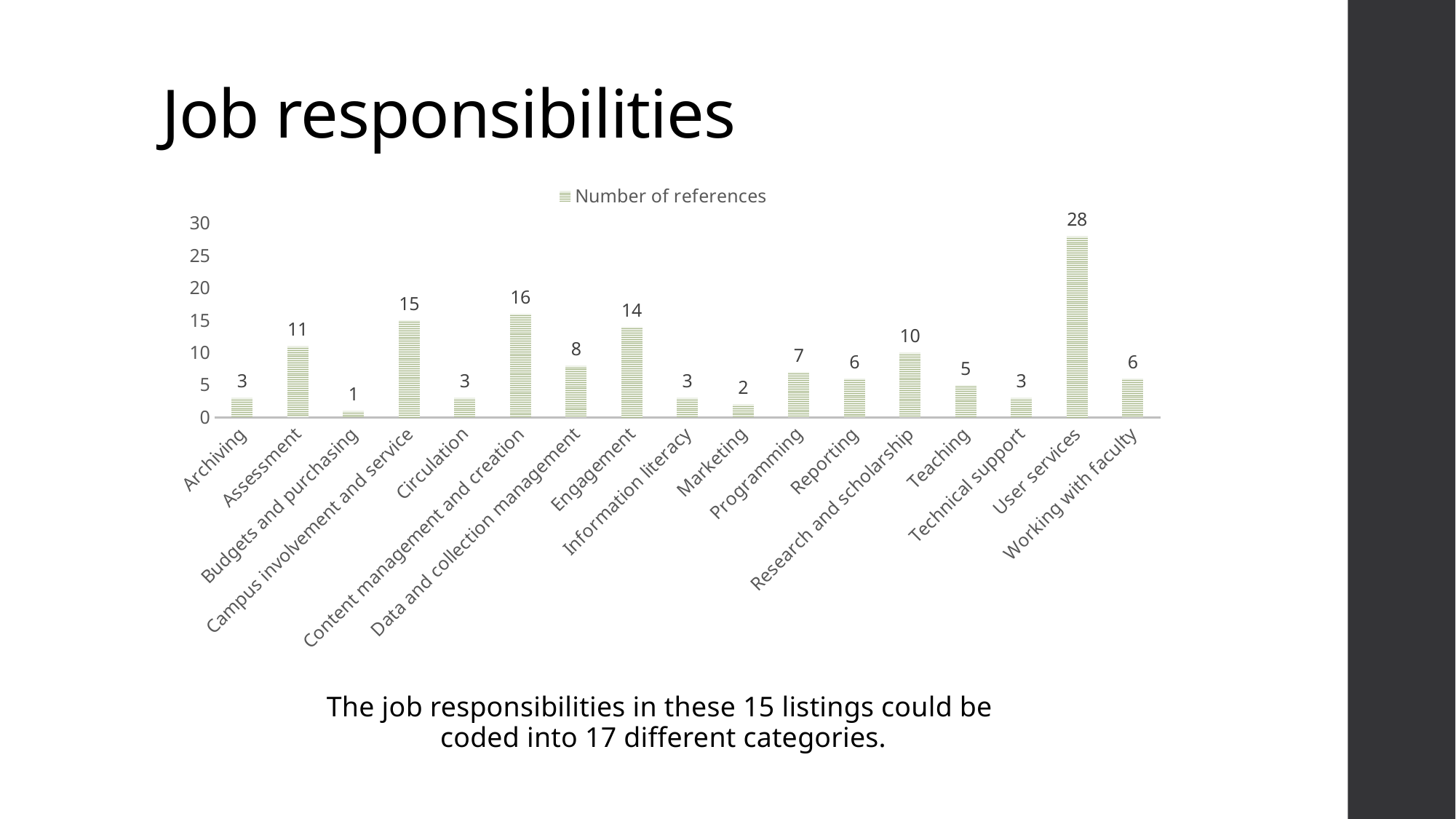
What is the legend entry of the chart? Number of references What is the difference in number of references between User services and Campus involvement and service? 13 How many categories are shown on the x axis of the chart? 17 Which has more references, Engagement or Assessment? Engagement Which category has the highest number of references? User services How many series does the legend list? 1 Which category has the lowest number of references? Budgets and purchasing Is the value for Data and collection management greater or less than 10? less What is the number of references for User services? 28 What is the number of references for Content management and creation? 16 What kind of chart is shown on the slide? Bar chart What is the number of references for Research and scholarship? 10